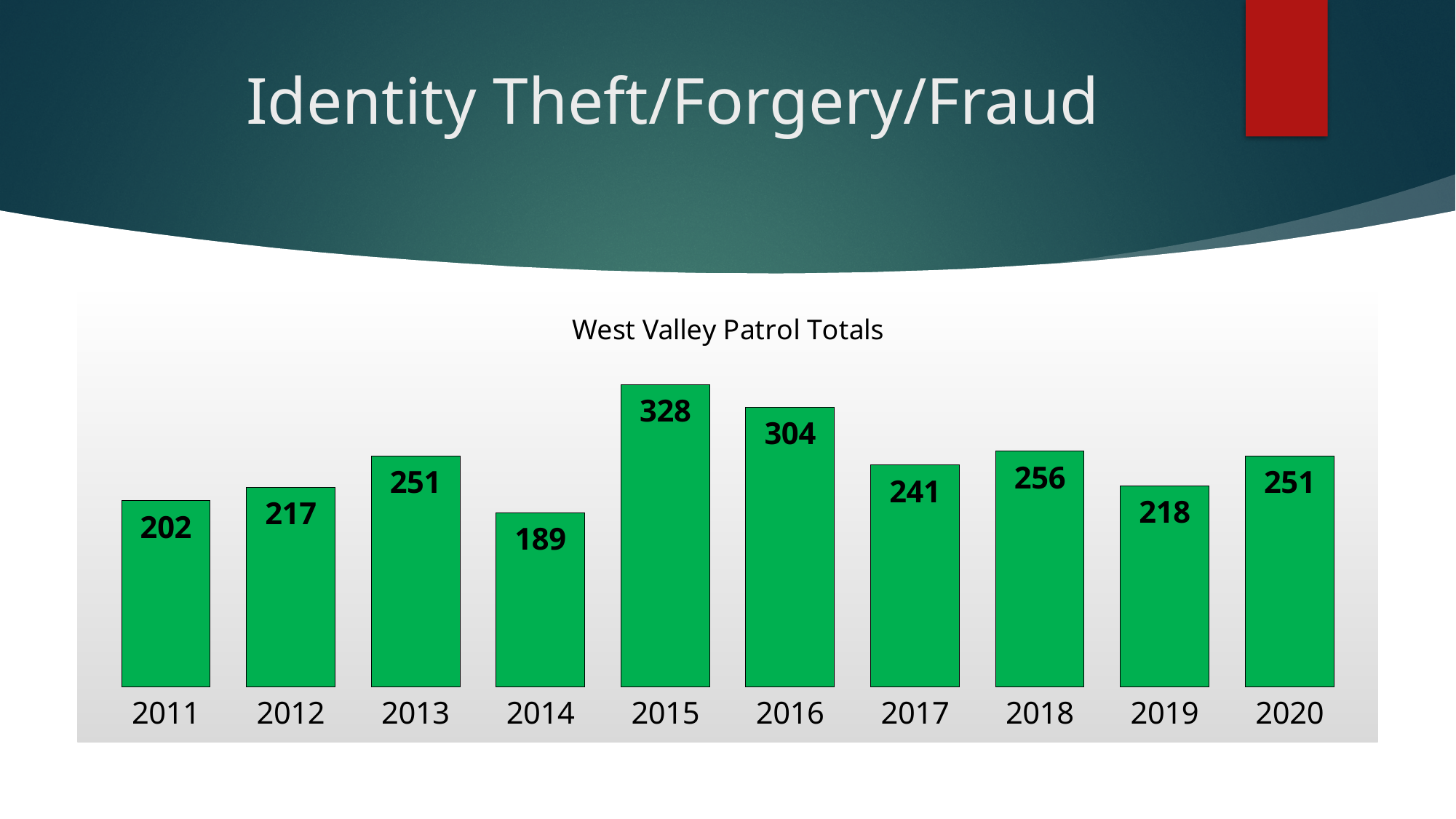
What is the value for 2014? 189 What is the value for 2019? 218 What is the value for 2015? 328 What kind of chart is shown on the slide? Bar chart Which is larger, the value for 2012 or the value for 2018? 2018 What is the difference between the values for 2015 and 2016? 24 Which year has the lowest value? 2014 Do the values rise or fall from 2016 to 2017? Fall What is the title of the chart? West Valley Patrol Totals How many years are shown on the x axis? 10 What is the difference between the values for 2013 and 2014? 62 Which year has the highest value? 2015